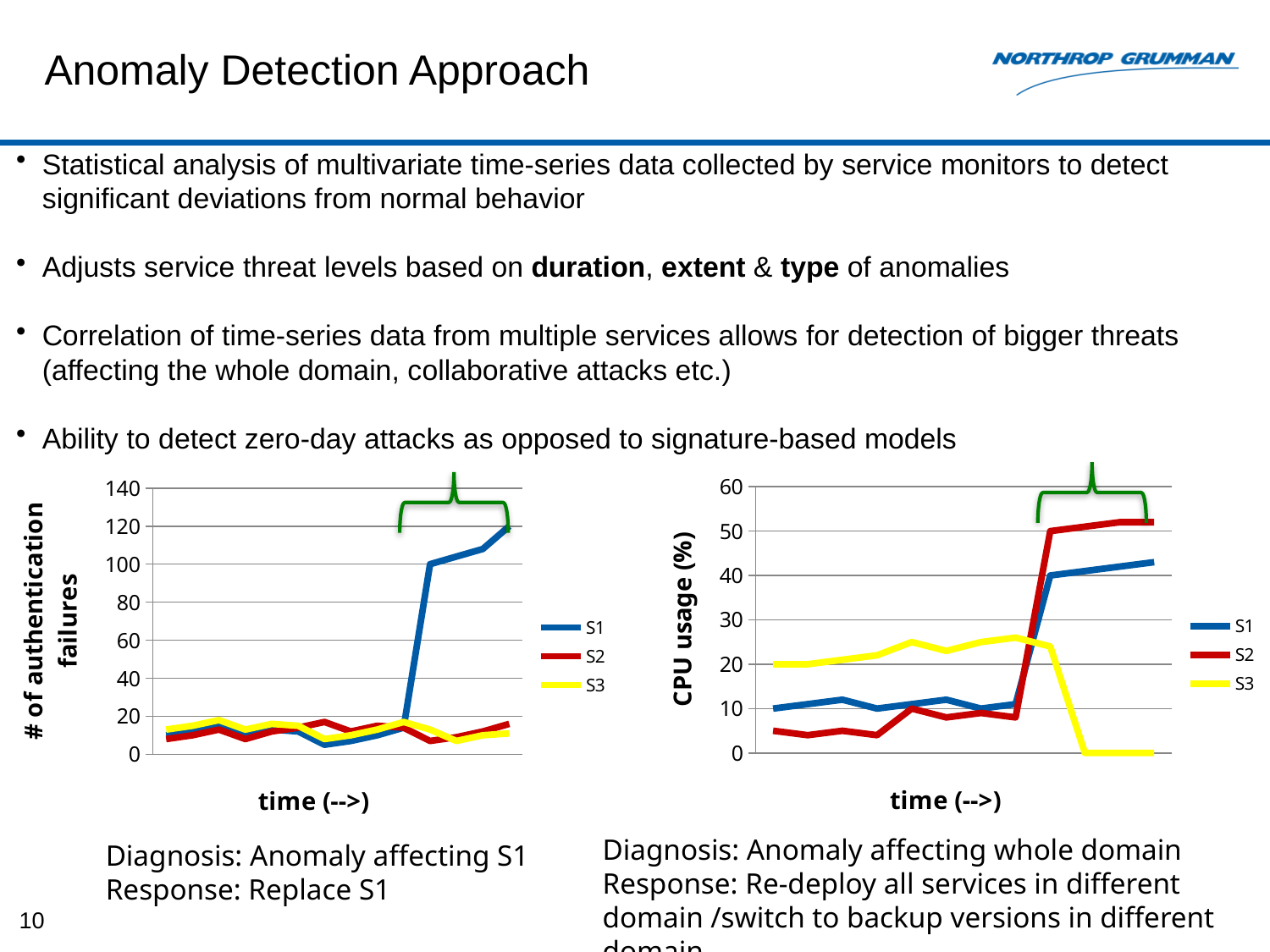
What is the y-axis label of the right chart? CPU usage (%) What is the x-axis label of the left chart? time (-->) What kind of chart is the left chart titled '# of authentication failures'? line chart In the right chart (CPU usage (%)), does the S3 series rise or fall toward the end of the time axis? fall How many series does the legend of the left chart (# of authentication failures) list? 3 How many series does the legend of the right chart (CPU usage (%)) list? 3 In the left chart (# of authentication failures), which series reaches the highest value? S1 In the right chart (CPU usage (%)), is the final value of S1 greater or less than 40? greater In the right chart (CPU usage (%)), which series has the larger value at the end of the time axis, S1 or S2? S2 In the left chart (# of authentication failures), is the highest value of S2 greater or less than 40? less In the left chart (# of authentication failures), is the final value of S1 greater or less than 100? greater